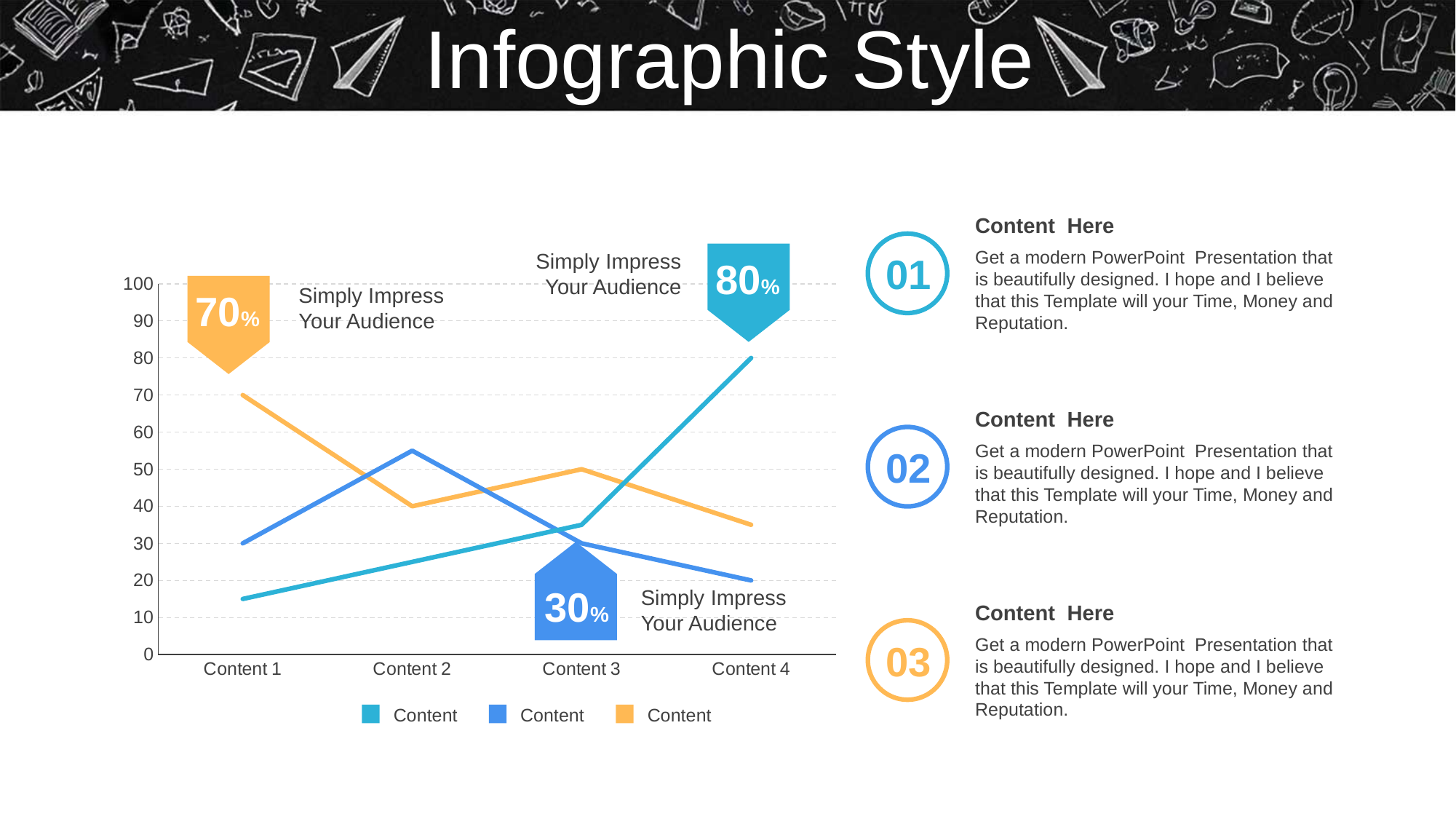
Which category has the lowest value on the orange line? Content 4 Does the teal line rise or fall from Content 1 to Content 4? rises How many categories are shown on the x axis of the chart? 4 What value does the blue callout label show for Content 3? 30% How many series does the chart's legend list? 3 What is the value of the orange line at Content 2? 40 What is the value of the blue line at Content 4? 20 What value does the teal callout label show for Content 4? 80% Which category has the highest value on the teal line? Content 4 What value does the orange callout label show for Content 1? 70% Is the value of the blue line at Content 2 greater or less than 50? greater What type of chart is shown on the slide? line chart